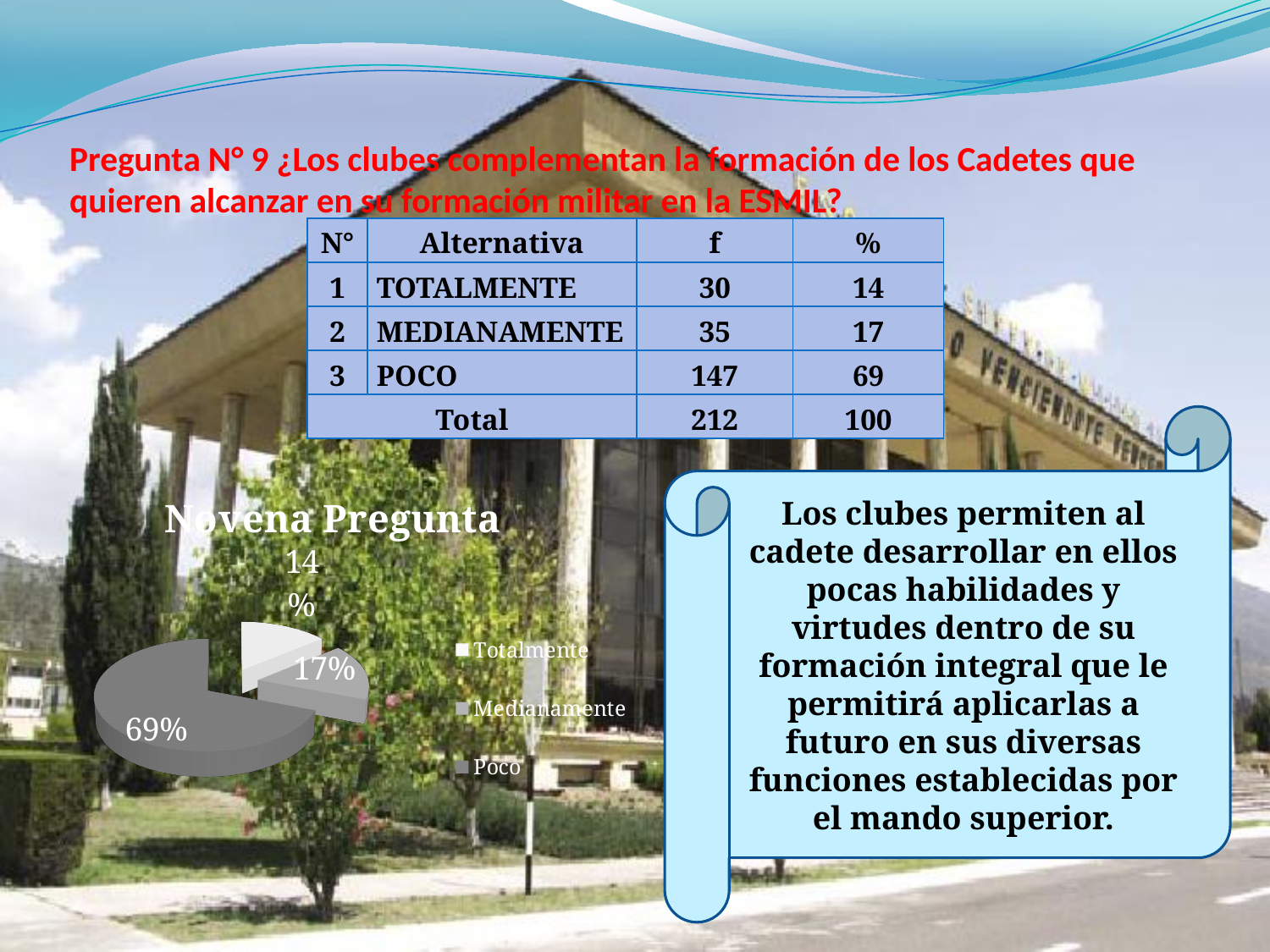
What kind of chart is shown on the slide? pie chart What percentage does the Totalmente slice show? 14% What percentage does the Medianamente slice show? 17% Which slice is larger, Medianamente or Totalmente? Medianamente How many slices does the pie chart have? 3 What is the difference in percentage points between the Poco slice and the Medianamente slice? 52 What percentage does the Poco slice show? 69% Which category has the largest slice of the pie? Poco What is the title of the chart? Novena Pregunta Which category has the smallest slice of the pie? Totalmente Which legend entry is listed first in the chart legend? Totalmente How many entries does the chart legend list? 3